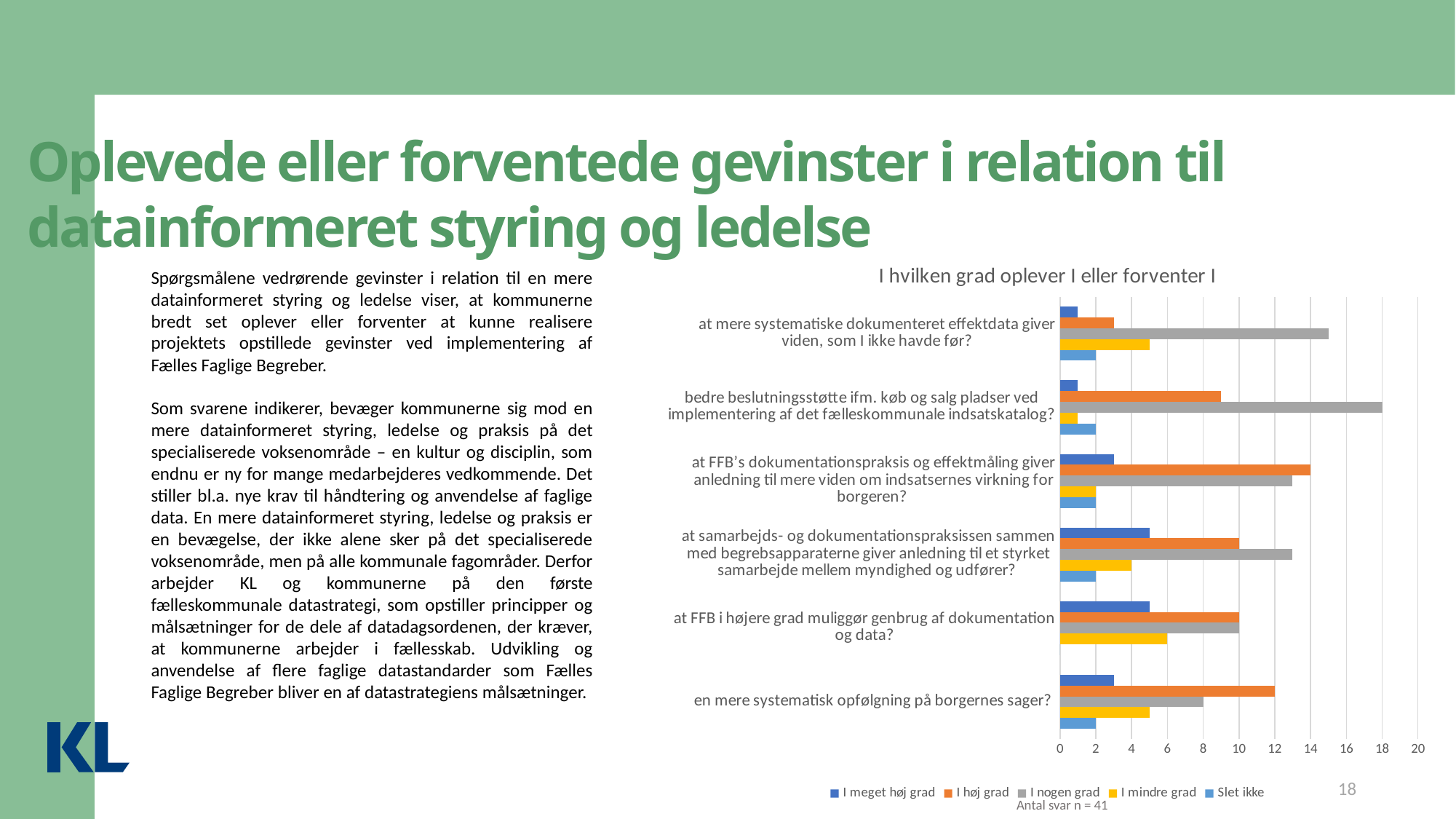
Which series in the legend is shown in orange? I høj grad For 'en mere systematisk opfølgning på borgernes sager?', which is larger: 'I høj grad' or 'I nogen grad'? I høj grad How many series does the chart legend list? 5 What is the title of the chart? I hvilken grad oplever I eller forventer I What is the value of 'I høj grad' for 'en mere systematisk opfølgning på borgernes sager?' 12 What kind of chart is shown on the slide? bar chart How many categories (questions) are plotted on the chart? 6 Is the 'I nogen grad' value for 'at mere systematiske dokumenteret effektdata giver viden, som I ikke havde før?' greater or less than 14? greater Is the 'I høj grad' value for 'bedre beslutningsstøtte ifm. køb og salg pladser ved implementering af det fælleskommunale indsatskatalog?' greater or less than 8? greater What is the value of 'I mindre grad' for 'at FFB i højere grad muliggør genbrug af dokumentation og data?' 6 What is the value of 'I nogen grad' for 'bedre beslutningsstøtte ifm. køb og salg pladser ved implementering af det fælleskommunale indsatskatalog?' 18 For which category is the 'I nogen grad' bar the longest? bedre beslutningsstøtte ifm. køb og salg pladser ved implementering af det fælleskommunale indsatskatalog?